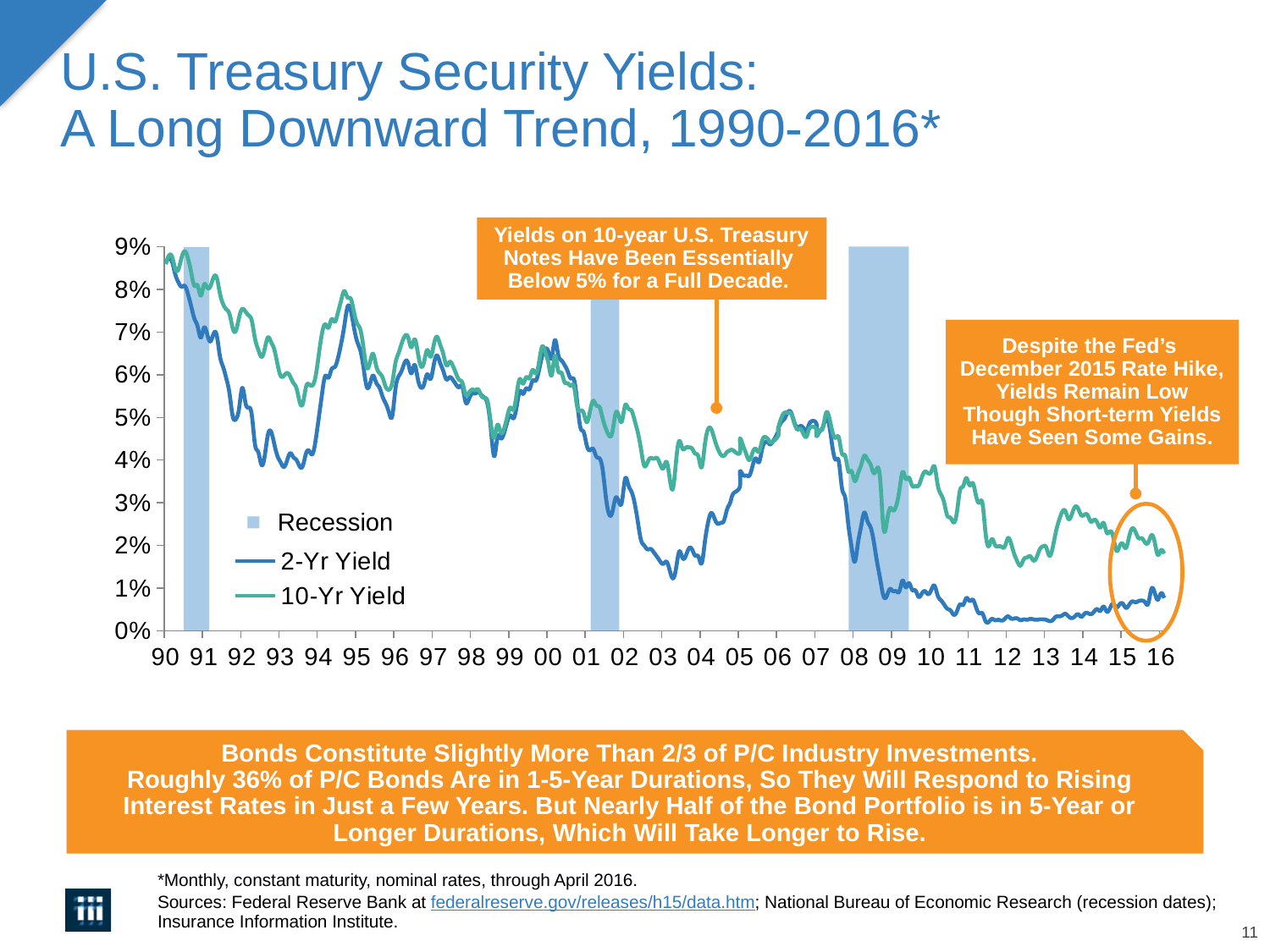
What are the two yield series plotted on the chart? 2-Yr Yield and 10-Yr Yield Overall, do Treasury yields rise or fall from 1990 to 2016 on the chart? Fall Is the 10-Yr Yield at the start of 1990 greater or less than 8%? greater What is the highest value labeled on the vertical axis? 9% In 2003, which is higher, the 2-Yr Yield or the 10-Yr Yield? 10-Yr Yield Is the 10-Yr Yield in 2016 greater or less than 3%? less What kind of chart is shown on the slide? Line chart Is the 2-Yr Yield in 2012 greater or less than 1%? less How many shaded recession periods are shown on the chart? 3 In 2012, which is higher, the 2-Yr Yield or the 10-Yr Yield? 10-Yr Yield How many entries does the chart legend list? 3